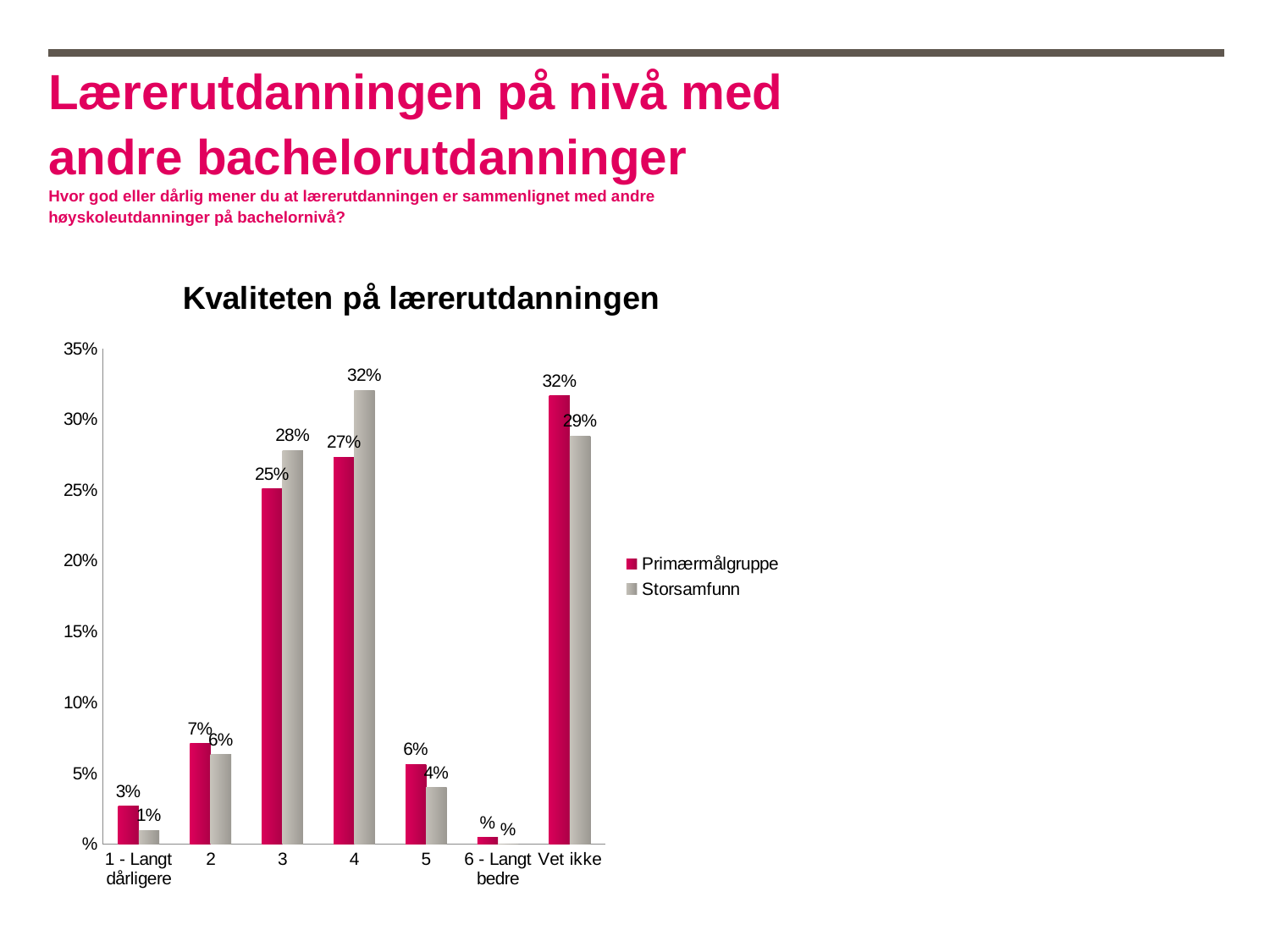
What is the difference between Storsamfunn and Primærmålgruppe in category 4? 5% What is the value for Primærmålgruppe in the 'Vet ikke' category? 32% Which category has the lowest value for Primærmålgruppe? 6 - Langt bedre What is the title of the chart? Kvaliteten på lærerutdanningen How many series does the legend list? 2 What kind of chart is shown on the slide? Bar chart Which category has the highest value for Storsamfunn? 4 What is the value for Primærmålgruppe in category 3? 25% What is the value for Storsamfunn in the '1 - Langt dårligere' category? 1% How many categories are shown on the x axis? 7 In category 5, which series has the larger value, Primærmålgruppe or Storsamfunn? Primærmålgruppe What is the value for Storsamfunn in category 4? 32%